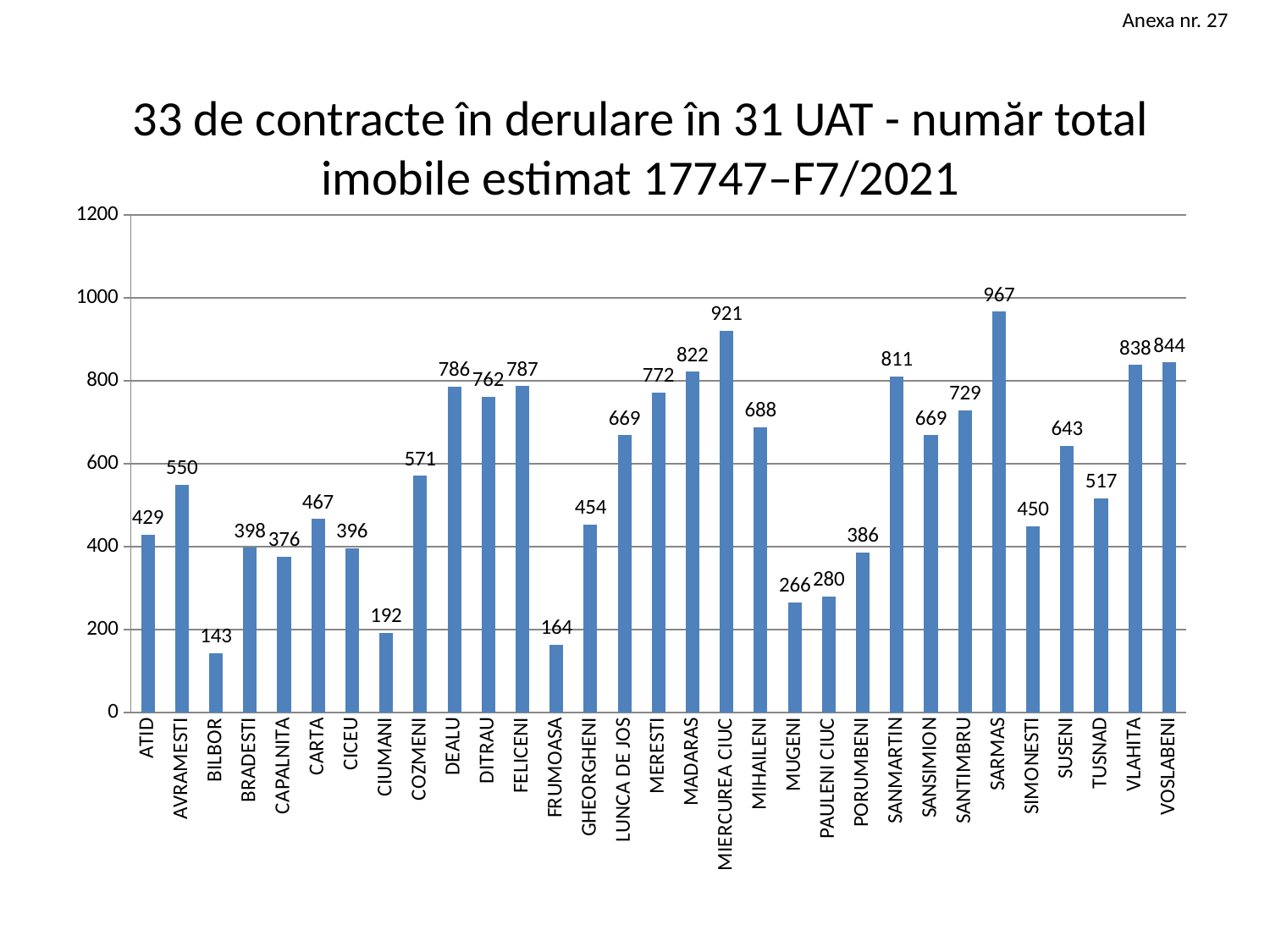
Which is larger, the value for MUGENI or the value for PAULENI CIUC? PAULENI CIUC Which category has the lowest value? BILBOR What is the title of the chart? 33 de contracte în derulare în 31 UAT - număr total imobile estimat 17747–F7/2021 Which is larger, the value for DEALU or the value for DITRAU? DEALU What is the value for BILBOR? 143 What is the value for SANTIMBRU? 729 What kind of chart is shown on the slide? Bar chart How many categories are shown on the x axis? 31 Which category has the highest value? SARMAS What is the difference between the values for SARMAS and FRUMOASA? 803 What is the difference between the values for VOSLABENI and VLAHITA? 6 What is the value for MIERCUREA CIUC? 921